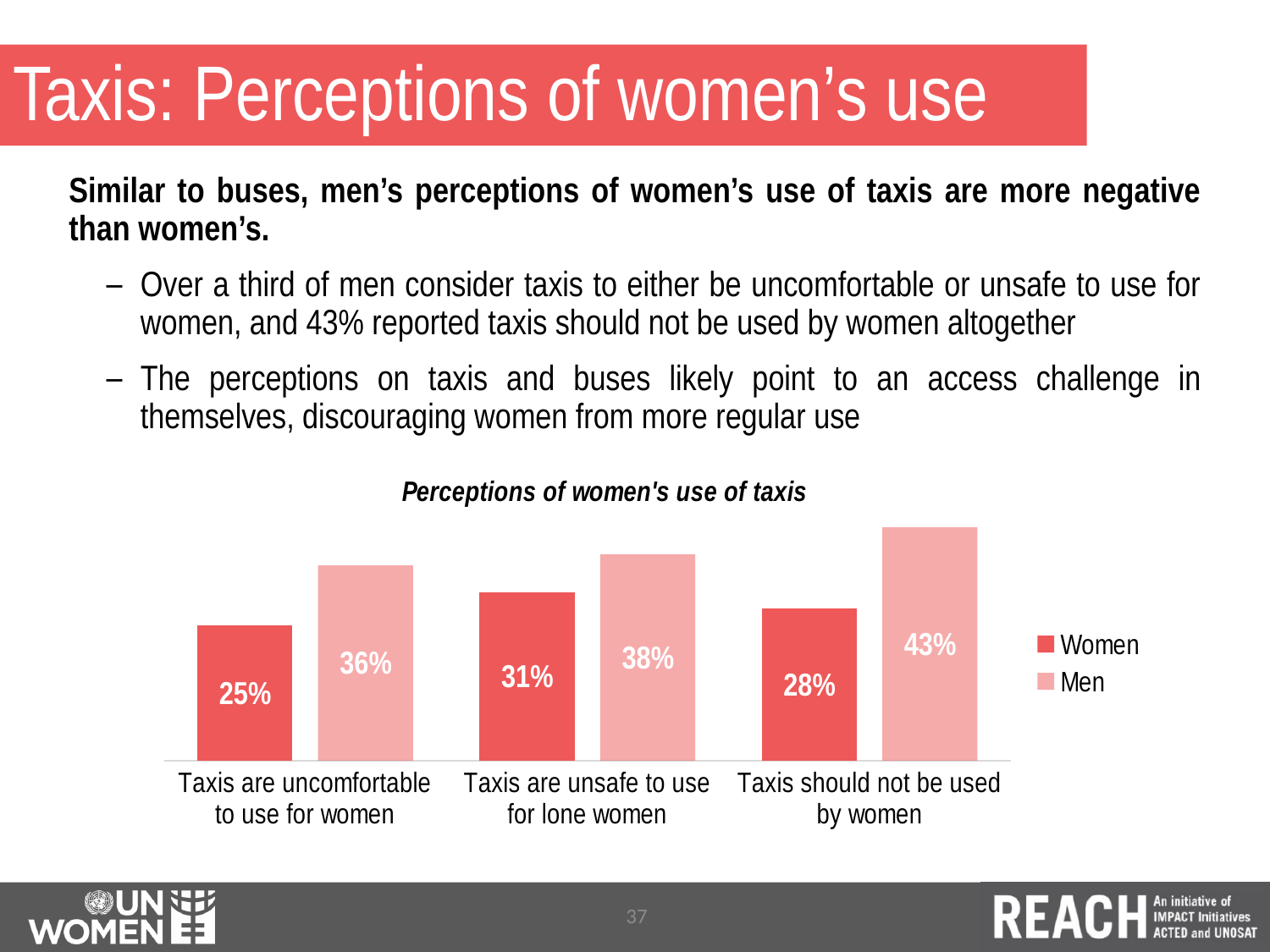
What percentage of men said taxis should not be used by women? 43% What kind of chart is shown on the slide? Bar chart What is the title of the chart? Perceptions of women's use of taxis What is the value for men for 'Taxis are unsafe to use for lone women'? 38% How many categories are shown on the x axis? 3 How many series does the legend list? 2 For 'Taxis are unsafe to use for lone women', which group has the higher value, women or men? Men Which category has the lowest value for women? Taxis are uncomfortable to use for women Which category has the highest value for men? Taxis should not be used by women What percentage of women said taxis are uncomfortable to use for women? 25% What is the difference between men's and women's values for 'Taxis should not be used by women'? 15% Which series is shown in the darker red colour? Women